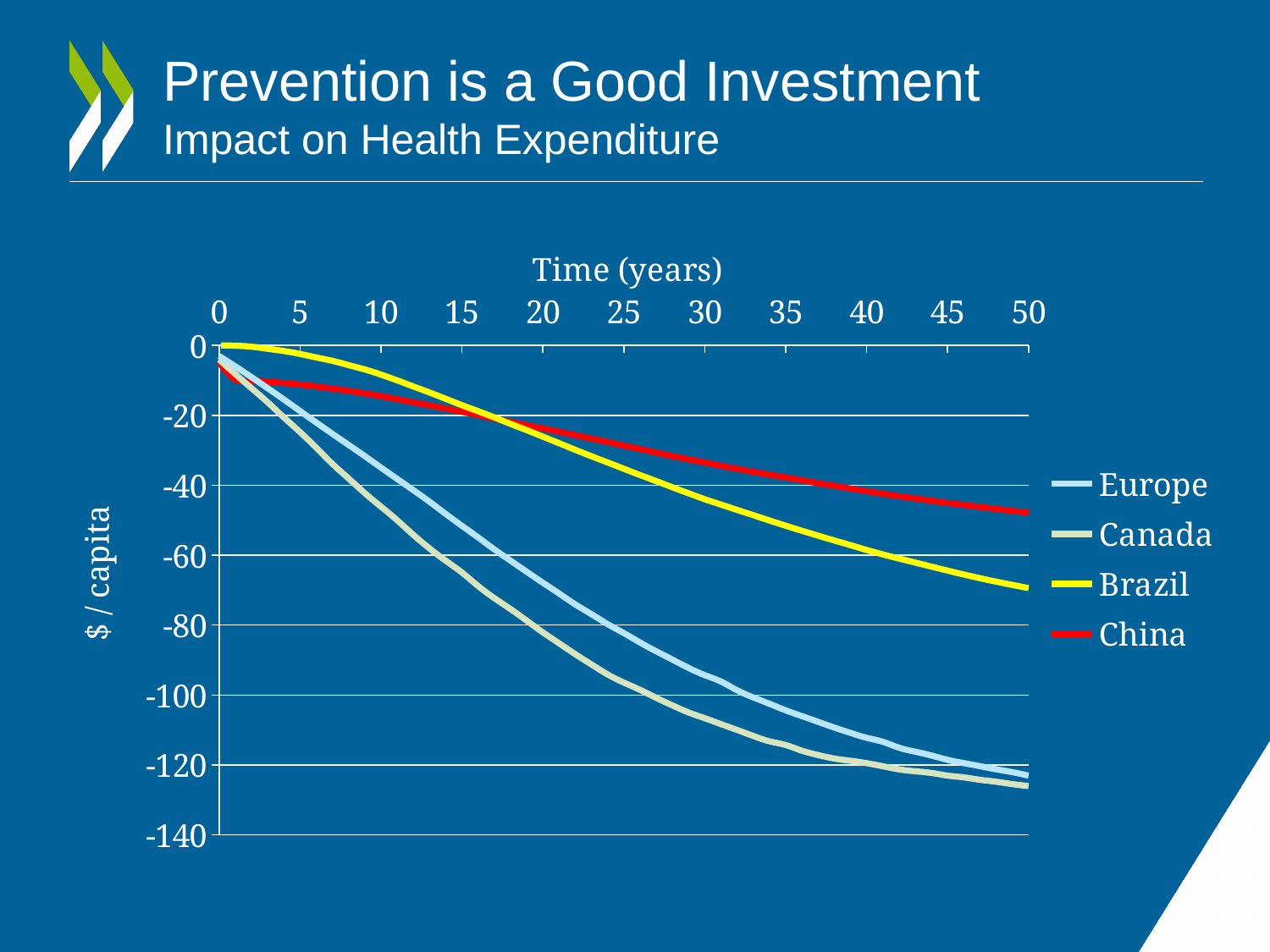
Which series are listed in the legend? Europe, Canada, Brazil, China Do the values for Europe rise or fall as time increases along the x axis? fall Is the value for Brazil at 25 years greater or less than -40? greater What kind of chart is shown on the slide? line chart At 50 years, which is higher: the value for China or the value for Brazil? China Is the value for Brazil at 50 years greater or less than -60? less How many series does the legend list? 4 Is the value for Canada at 25 years greater or less than -80? less How many tick labels are shown on the x axis? 11 What is the title of the x axis? Time (years) Which series has the highest (least negative) value at 50 years? China